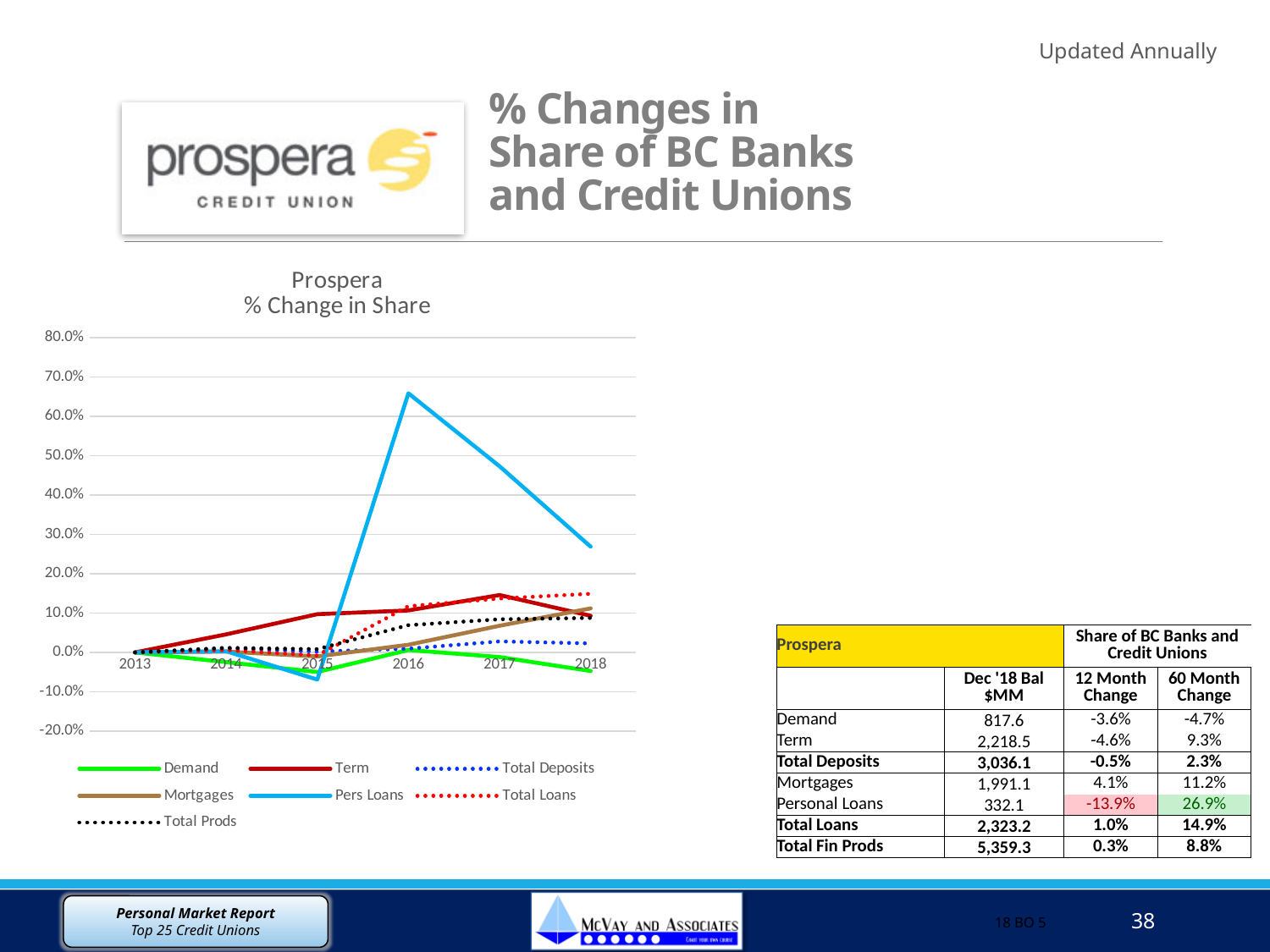
Is the value for Pers Loans in 2018 greater or less than 20.0%? greater What is the title of the chart? Prospera % Change in Share Does the Term line rise or fall from 2013 to 2016? rise Is the value for Demand in 2018 greater or less than 0.0%? less Does the Pers Loans line rise or fall from 2016 to 2018? fall What kind of chart is shown on the slide? line chart How many years are shown along the x axis of the chart? 6 How many series does the chart legend list? 7 Which series has the lowest value in 2018? Demand In 2018, which is larger: the value for Pers Loans or the value for Demand? Pers Loans Which series has the highest value in 2016? Pers Loans Is the value for Pers Loans in 2016 greater or less than 60.0%? greater